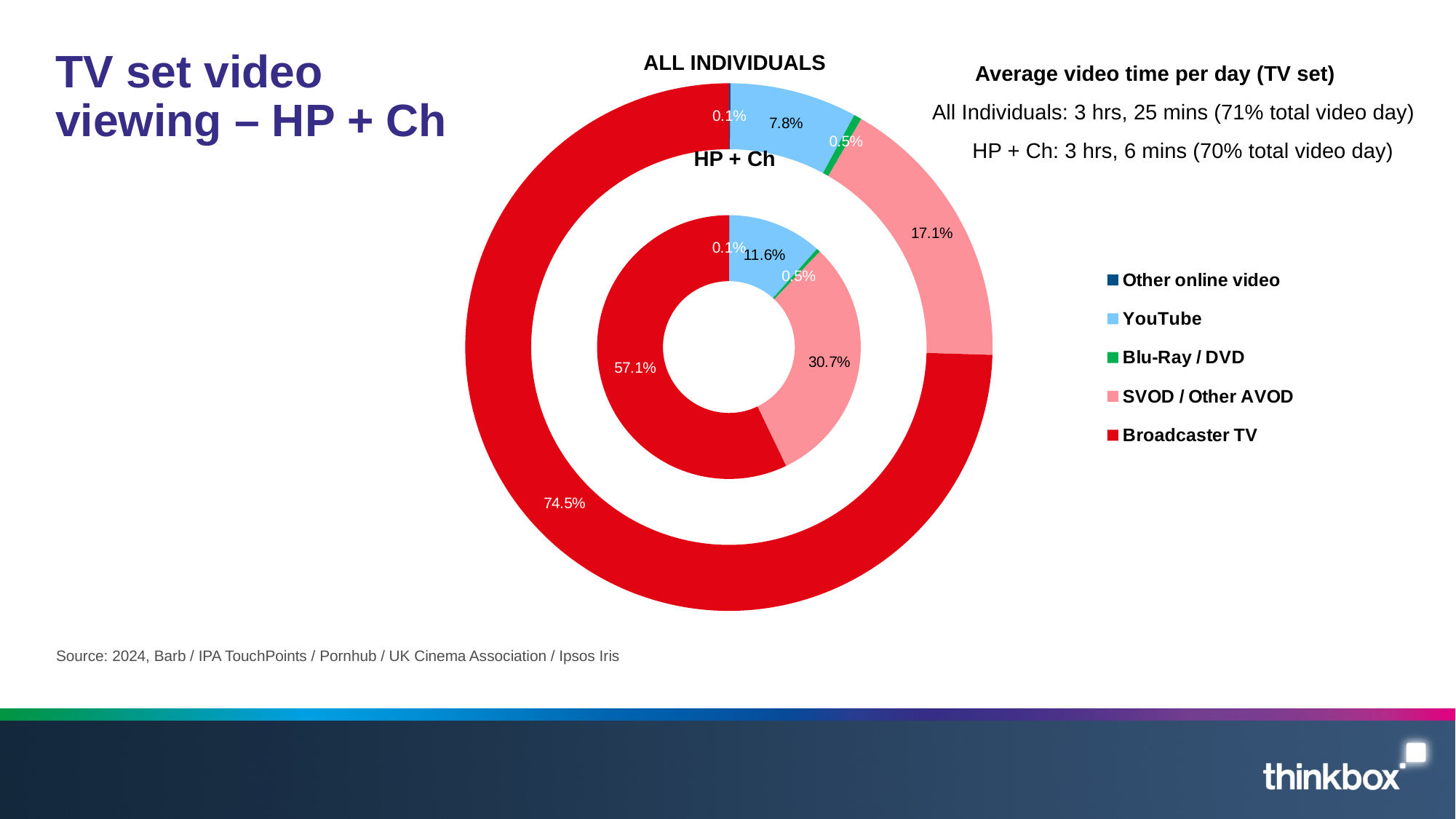
What is the YouTube share for All Individuals (outer ring)? 7.8% Which colour represents Blu-Ray / DVD in the chart? Green What is the SVOD / Other AVOD share for HP + Ch (inner ring)? 30.7% Which category has the smallest share in the HP + Ch ring? Other online video Which category has the largest share in the All Individuals ring? Broadcaster TV What is the difference between the Broadcaster TV share for All Individuals and for HP + Ch? 17.4 percentage points What share of TV set video viewing is Broadcaster TV for All Individuals (outer ring)? 74.5% Is the YouTube share larger for All Individuals or for HP + Ch? HP + Ch What is the difference between the SVOD / Other AVOD share for HP + Ch and for All Individuals? 13.6 percentage points What share of TV set video viewing is Broadcaster TV for HP + Ch (inner ring)? 57.1% What type of chart is shown on the slide? Doughnut chart How many categories does the legend list? 5